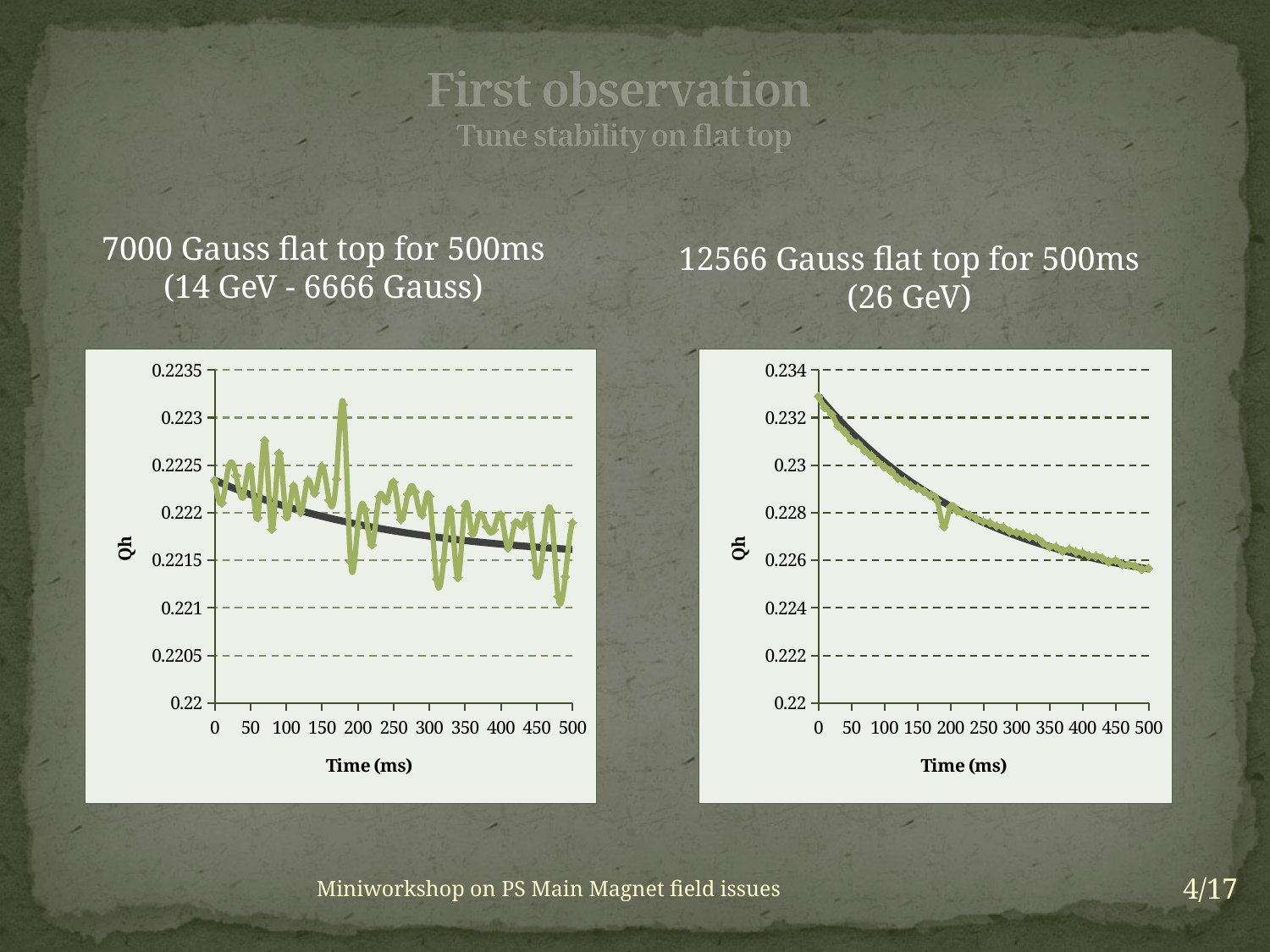
In the left chart (7000 Gauss flat top), does the smooth dark line rise or fall as time increases from 0 to 500 ms? fall What kind of chart is the right chart titled '12566 Gauss flat top for 500ms'? line chart In the right chart (12566 Gauss flat top), is the Qh value at 0 ms greater or less than 0.23? greater What is the x-axis label of the right chart (12566 Gauss flat top)? Time (ms) In the left chart (7000 Gauss flat top), is the Qh value at 0 ms greater or less than 0.223? less How many tick marks are labelled on the x axis of the right chart (12566 Gauss flat top)? 11 In the left chart (7000 Gauss flat top), is the lowest point of the noisy line, near 490 ms, greater or less than 0.2215? less In the right chart (12566 Gauss flat top), does Qh rise or fall as time increases from 0 to 500 ms? fall How many lines are plotted in the left chart (7000 Gauss flat top)? 2 What kind of chart is the left chart titled '7000 Gauss flat top for 500ms'? line chart What is the y-axis label of the left chart (7000 Gauss flat top)? Qh